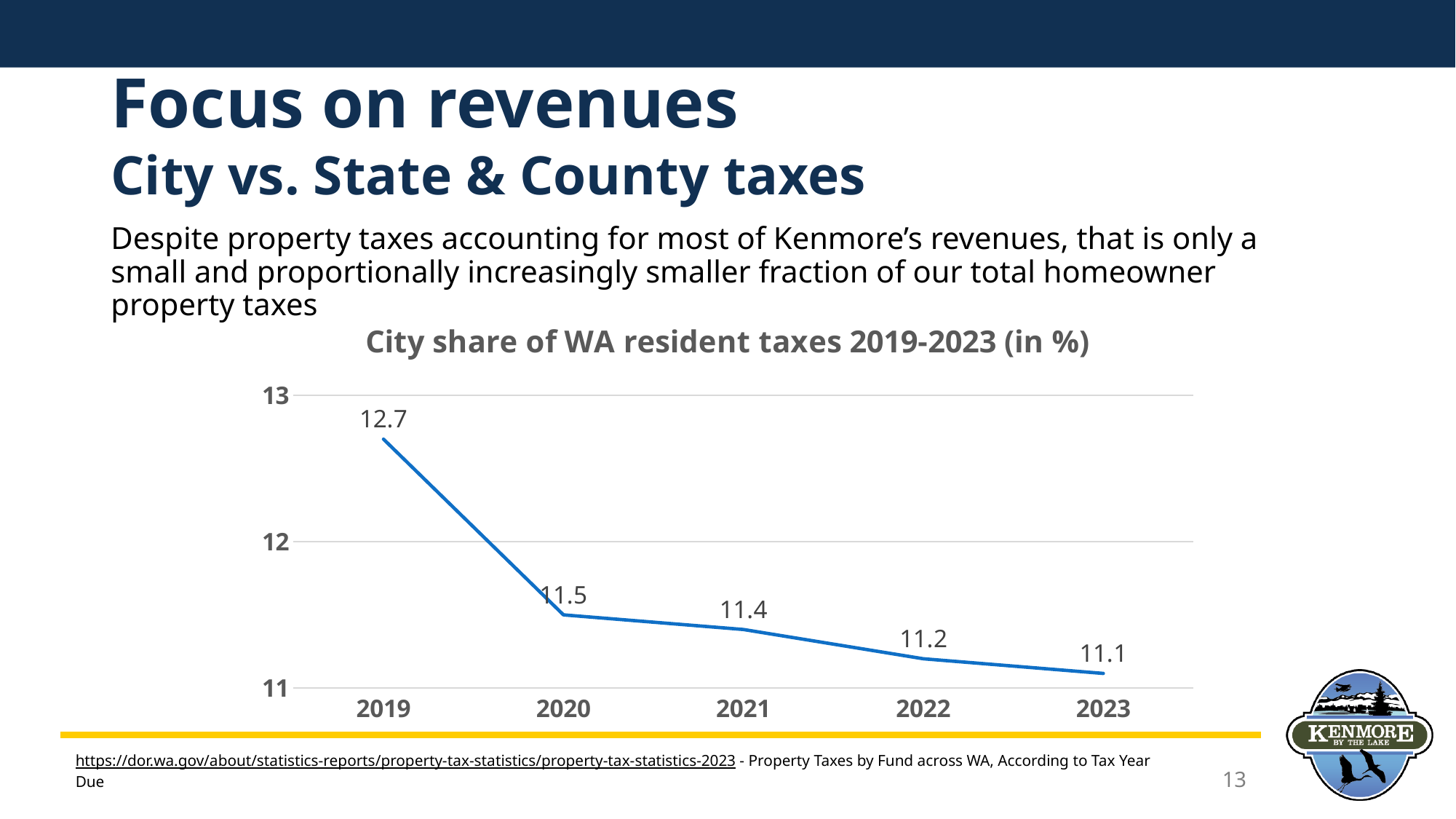
Which year has the lowest city share of WA resident taxes? 2023 Is the city share for 2019 greater or less than 12? greater What kind of chart is shown on the slide? line chart Which year has the highest city share of WA resident taxes? 2019 What is the difference between the city share in 2019 and in 2023? 1.6 What is the city share of WA resident taxes in 2023? 11.1 Which year has a larger city share, 2020 or 2022? 2020 What is the difference between the city share in 2020 and in 2022? 0.3 What is the city share of WA resident taxes in 2019? 12.7 Does the city share of WA resident taxes rise or fall from 2019 to 2023? fall How many years are plotted on the chart? 5 What is the city share of WA resident taxes in 2021? 11.4